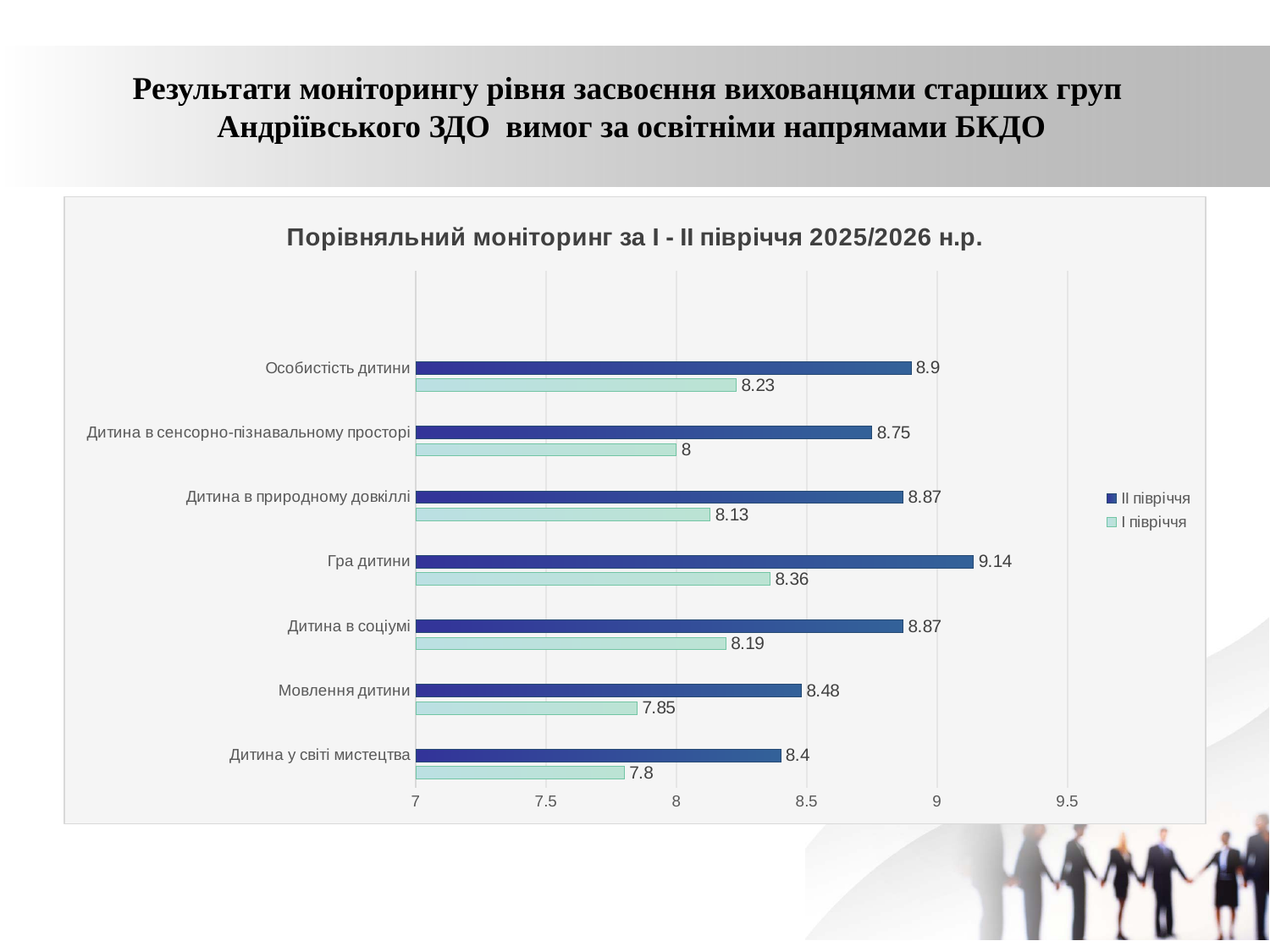
What is the value for "Гра дитини" in the "ІІ півріччя" series? 9.14 What is the difference between the "ІІ півріччя" and "І півріччя" values for "Мовлення дитини"? 0.63 What is the value for "Мовлення дитини" in the "І півріччя" series? 7.85 Which category has the highest value in the "ІІ півріччя" series? Гра дитини What is the difference between the "ІІ півріччя" and "І півріччя" values for "Гра дитини"? 0.78 Which is larger: the "ІІ півріччя" value for "Особистість дитини" or for "Дитина в сенсорно-пізнавальному просторі"? Особистість дитини What kind of chart is shown on the slide? bar chart What is the value for "Дитина в сенсорно-пізнавальному просторі" in the "І півріччя" series? 8 Which category has the lowest value in the "І півріччя" series? Дитина у світі мистецтва How many series does the legend list? 2 Is the "І півріччя" value for "Дитина у світі мистецтва" greater or less than 8? less How many categories are shown on the chart? 7